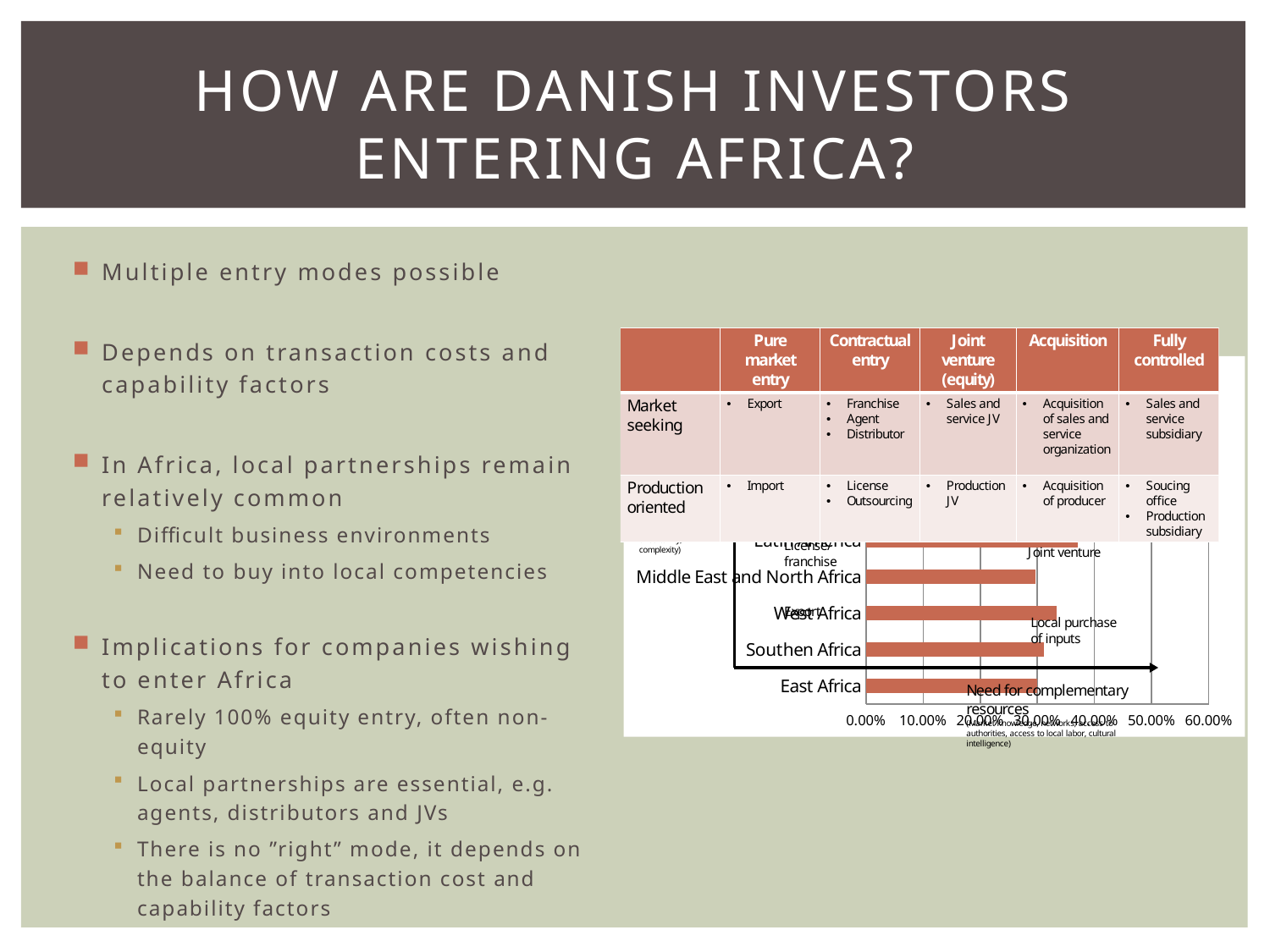
What kind of chart is shown on the right side of the slide? bar chart Is the value for Southen Africa greater or less than 40.00%? less Is the value for East Africa greater or less than 50.00%? less Is the value for Middle East and North Africa greater or less than 40.00%? less What is the highest value shown on the chart's horizontal axis? 60.00% Are the bars in the chart drawn horizontally or vertically? horizontally